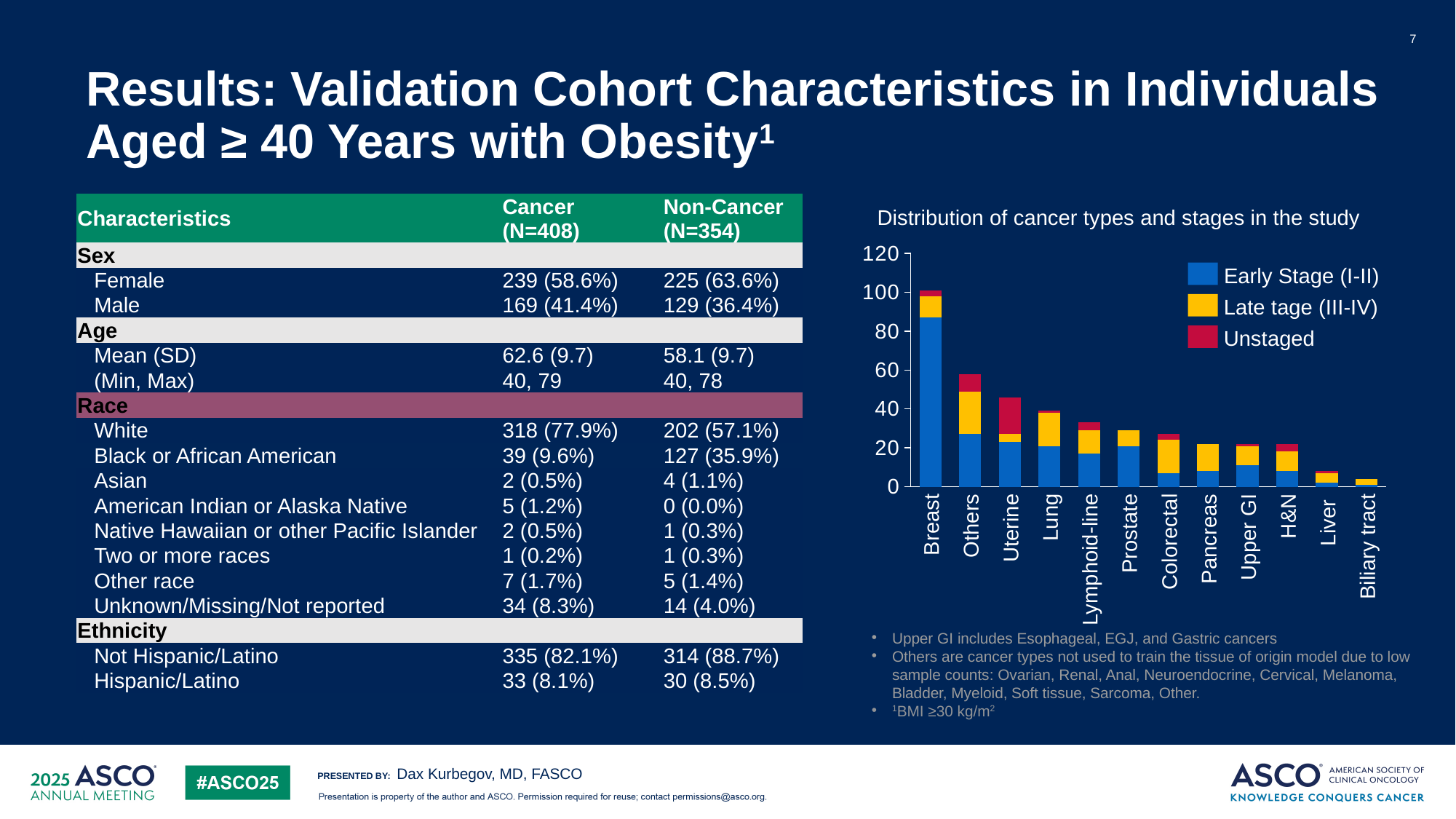
Which cancer type has the shortest bar in the chart? Biliary tract Is the total bar height for Prostate greater or less than 40? less Do the total bar heights generally rise or fall moving from left to right along the x axis? fall Which bar is taller in the chart, Breast or Others? Breast Which cancer type has the tallest bar in the chart? Breast What kind of chart is shown on the slide? Stacked bar chart How many cancer type categories are shown on the x axis of the chart? 12 How many series does the chart legend list? 3 What is the title of the chart? Distribution of cancer types and stages in the study Which bar is taller in the chart, Lung or Liver? Lung Is the total bar height for Others greater or less than 40? greater Is the total bar height for Liver greater or less than 20? less